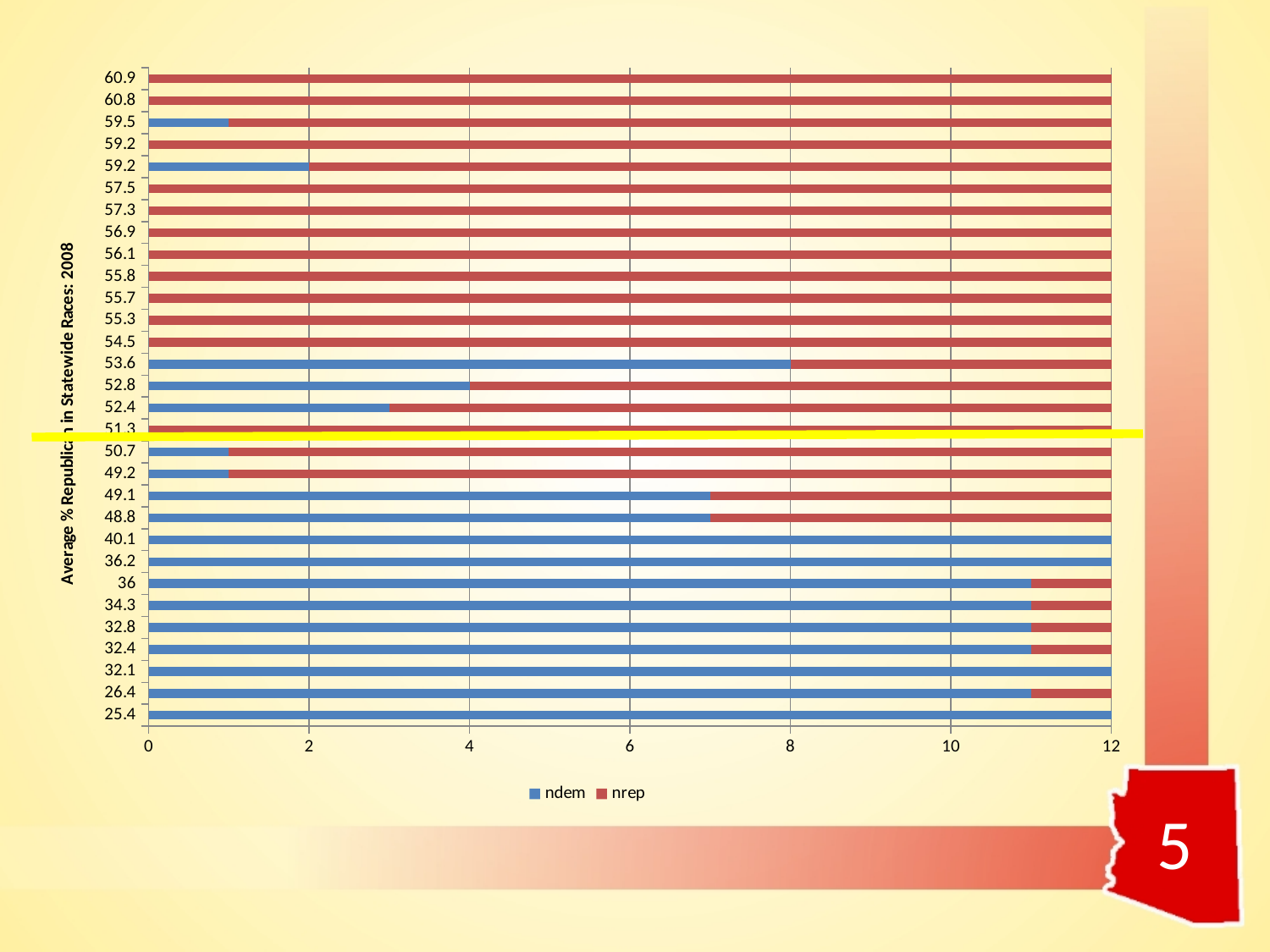
How many categories are plotted on the vertical axis? 30 What kind of chart is shown on the slide? bar chart What is the total of the stacked bar for the category labelled 53.6? 12 Which category has the larger ndem value, 53.6 or 52.8? 53.6 What is the ndem value for the category labelled 40.1? 12 What is the ndem value for the category labelled 52.8? 4 How many series does the legend list? 2 Is the ndem value for the category labelled 49.1 greater or less than 6? greater Is the nrep value for the category labelled 36 greater or less than 2? less What are the two entries in the legend? ndem and nrep What is the ndem value for the category labelled 53.6? 8 What is the nrep value for the category labelled 60.9? 12